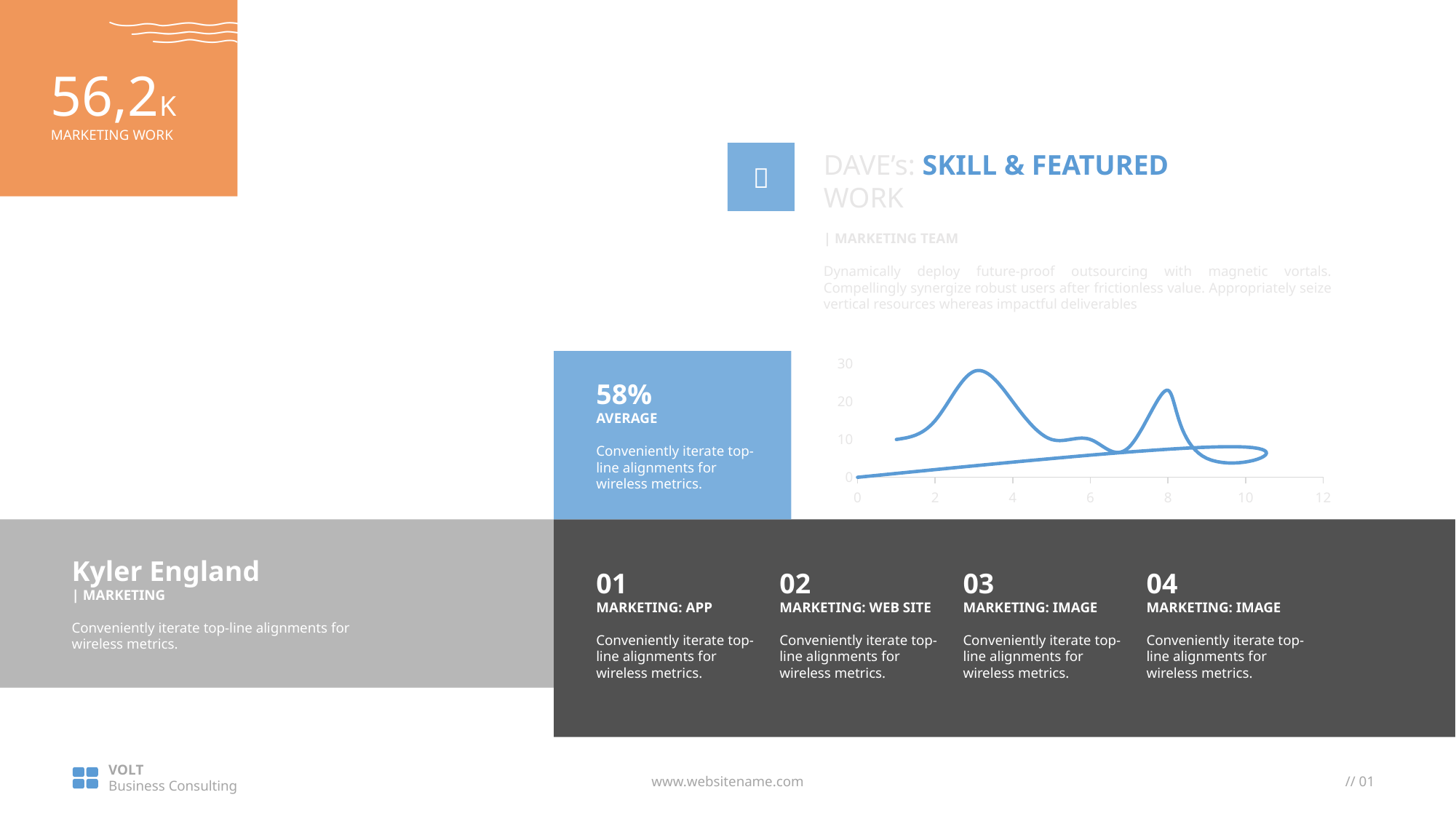
What kind of chart is shown on the slide? line chart What is the highest value shown on the chart's y axis? 30 At x = 3, which line has the higher value, the curved line or the straight line? the curved line Is the value of the straight line at x = 10 greater or less than 10? less Is the value of the curved line at x = 5 greater or less than 20? less Is the value of the curved line at its second peak (near x = 8) greater or less than 20? greater How many lines are plotted on the chart? 2 Does the straight line rise or fall as x increases from 0 to 10? rise